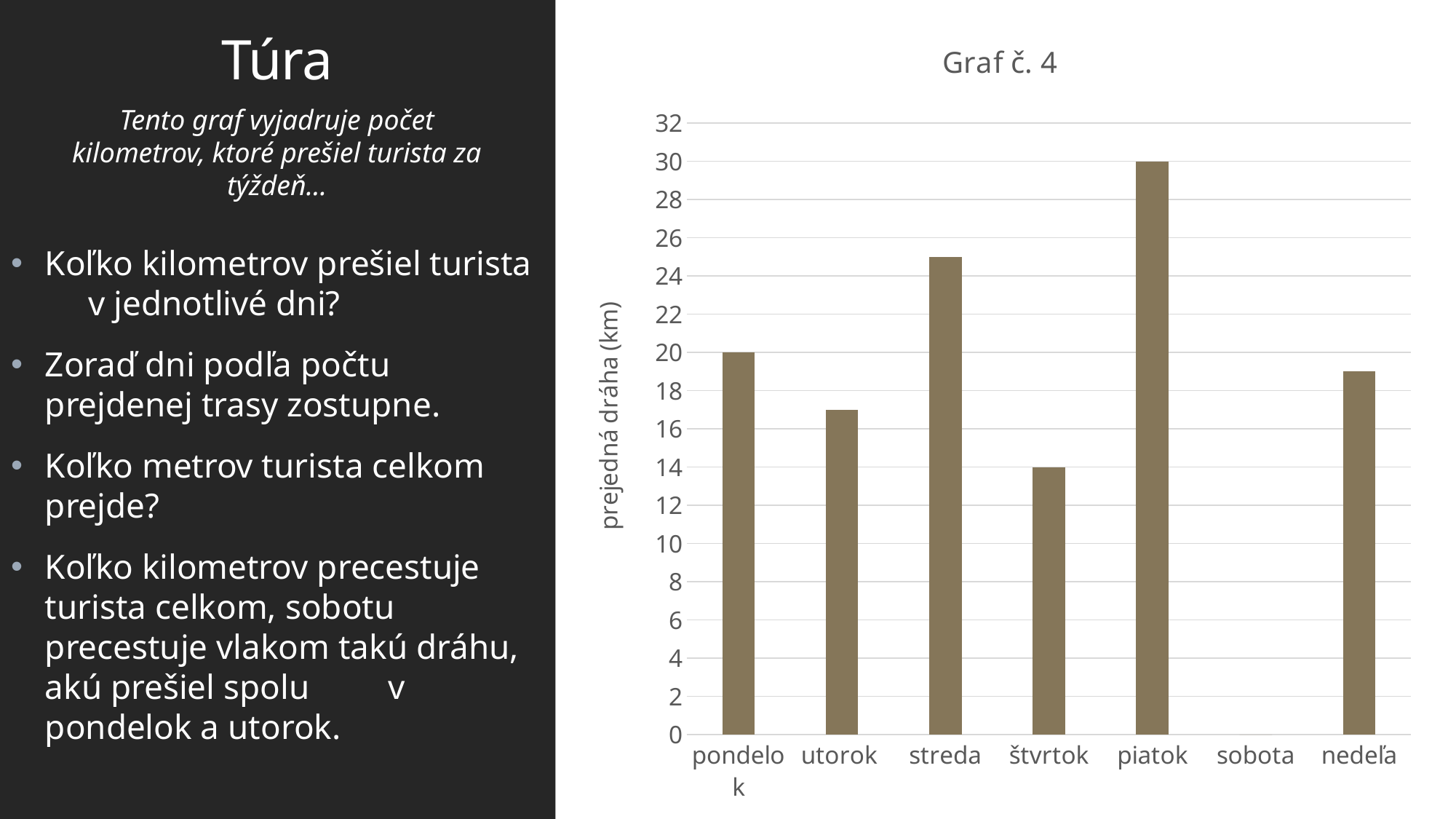
What is the label of the vertical axis? prejedná dráha (km) Is the value for streda greater or less than 24? greater What is the difference between the values for piatok and pondelok? 10 How many days (categories) are shown on the x axis? 7 Which day has the lowest value (no bar shown)? sobota What type of chart is shown on the slide? bar chart What is the title of the chart? Graf č. 4 Which day has the highest value? piatok What is the value for štvrtok? 14 What is the value for piatok? 30 Is the value for nedeľa greater or less than 20? less What is the value for pondelok? 20